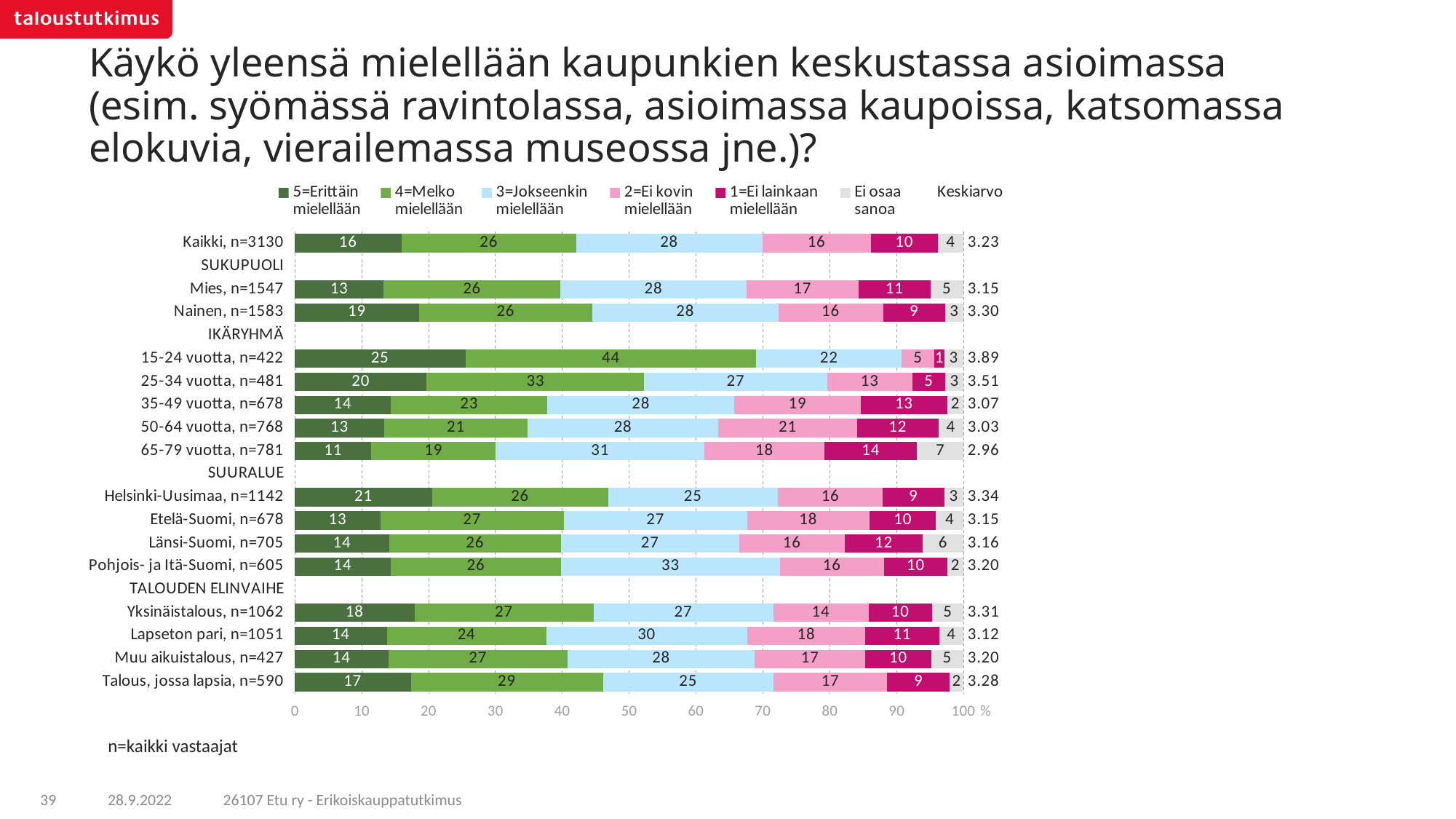
How many respondent groups (bars) are plotted on the chart? 16 Does the Keskiarvo value rise or fall as the age groups get older, from 15-24 vuotta to 65-79 vuotta? Fall What percentage of the 65-79 vuotta group answered Ei osaa sanoa? 7 Which has a larger 5=Erittäin mielellään share, Helsinki-Uusimaa or Länsi-Suomi? Helsinki-Uusimaa What is the difference in the 5=Erittäin mielellään share between Nainen and Mies? 6 What percentage of the 15-24 vuotta group answered 4=Melko mielellään? 44 What percentage of all respondents (Kaikki, n=3130) answered 5=Erittäin mielellään? 16 What kind of chart is shown on the slide? Stacked bar chart Which group has the lowest Keskiarvo value on the chart? 65-79 vuotta What is the Keskiarvo (mean) value for the 15-24 vuotta age group? 3.89 How many response categories does the legend list? 6 Which age group has the highest share of 5=Erittäin mielellään answers? 15-24 vuotta